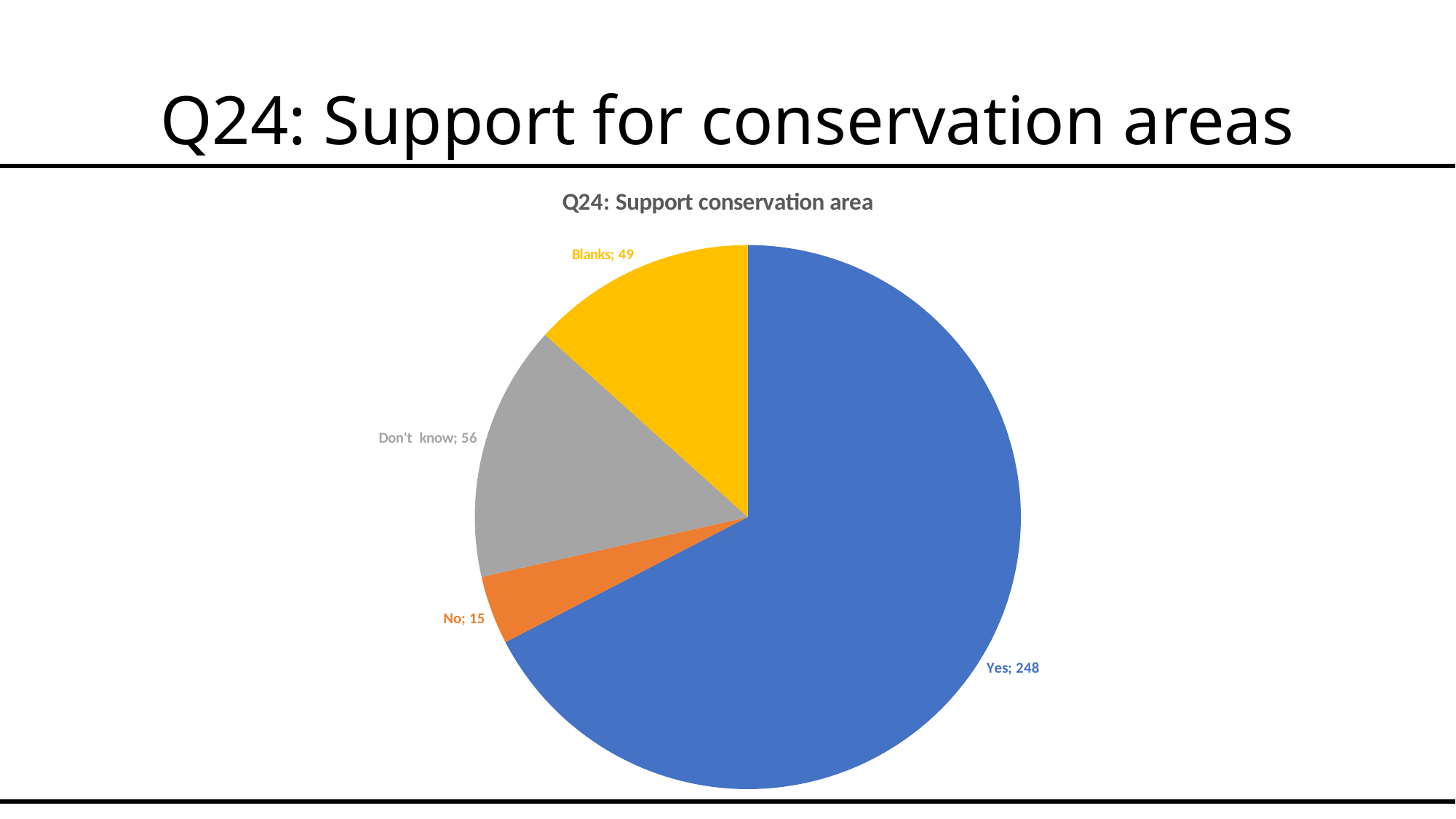
How many categories are shown in the pie chart? 4 What is the value for Yes in the pie chart? 248 What is the value for Don't know in the pie chart? 56 What is the difference between the Don't know and Blanks values? 7 What type of chart is shown on the slide? Pie chart What is the value for No in the pie chart? 15 What is the title of the chart? Q24: Support conservation area Which is larger, the Don't know slice or the Blanks slice? Don't know What is the value for Blanks in the pie chart? 49 Which category has the largest slice of the pie? Yes What is the difference between the Yes and Don't know values? 192 Which category has the smallest slice of the pie? No